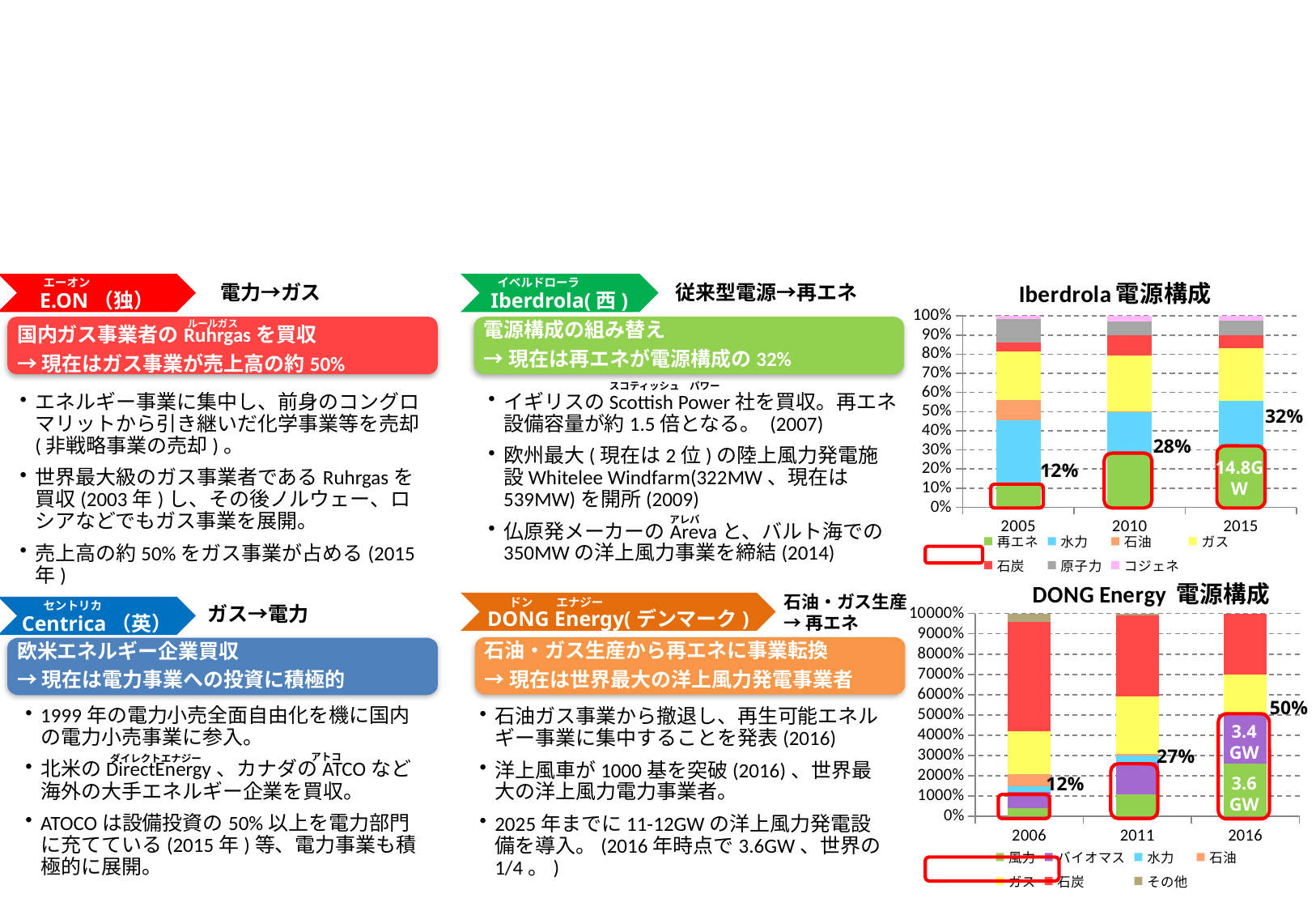
What kind of chart is the 'Iberdrola 電源構成' chart? stacked bar chart In the 'Iberdrola 電源構成' chart, by how many percentage points did the labelled renewable share increase from 2005 to 2015? 20% In the 'DONG Energy 電源構成' chart, what capacity is labelled on the wind (風力) segment for 2016? 3.6GW In the 'Iberdrola 電源構成' chart, how many years are shown on the x axis? 3 In the 'DONG Energy 電源構成' chart, how many series does the legend list? 7 In the 'Iberdrola 電源構成' chart, what capacity is labelled on the 2015 renewable segment? 14.8GW In the 'Iberdrola 電源構成' chart, does the labelled renewable share rise or fall from 2005 to 2015? rise In the 'Iberdrola 電源構成' chart, how many series does the legend list? 7 In the 'Iberdrola 電源構成' chart, what renewable share is labelled for 2015? 32% In the 'DONG Energy 電源構成' chart, what percentage is labelled for 2016? 50% In the 'Iberdrola 電源構成' chart, what renewable share is labelled for 2005? 12% In the 'DONG Energy 電源構成' chart, what percentage is labelled for 2011? 27%